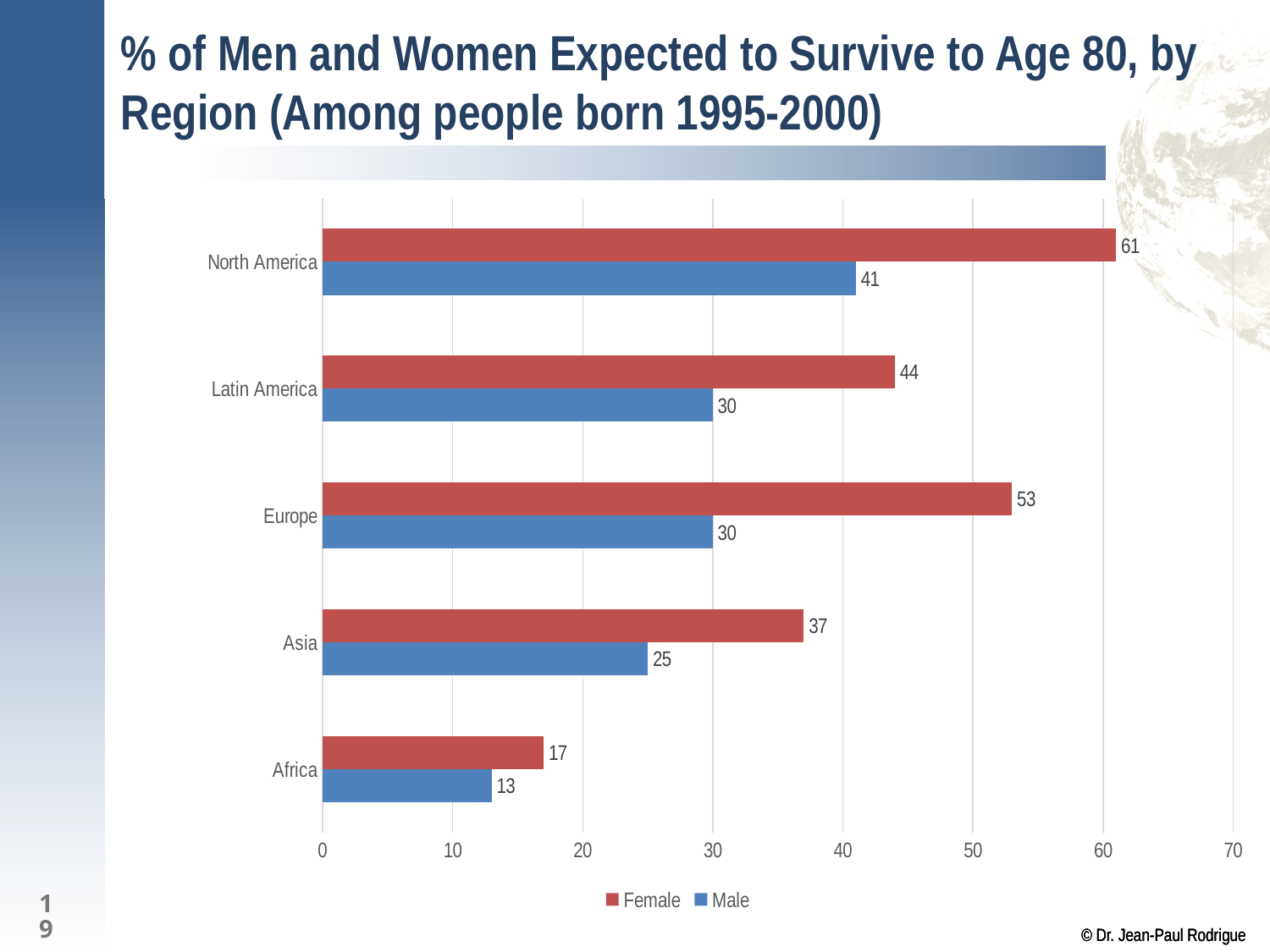
Which is larger, the Female value for Latin America or the Female value for Europe? Europe What is the difference between the Female values for Europe and Asia? 16 What is the Female value for North America? 61 How many regions are shown on the chart? 5 Which region has the lowest Male value? Africa What kind of chart is shown on the slide? Bar chart What is the Female value for Europe? 53 What is the difference between the Female and Male values for North America? 20 Which colour represents the Male series in the legend? Blue What is the Male value for Asia? 25 How many series does the legend list? 2 Which region has the highest Female value? North America